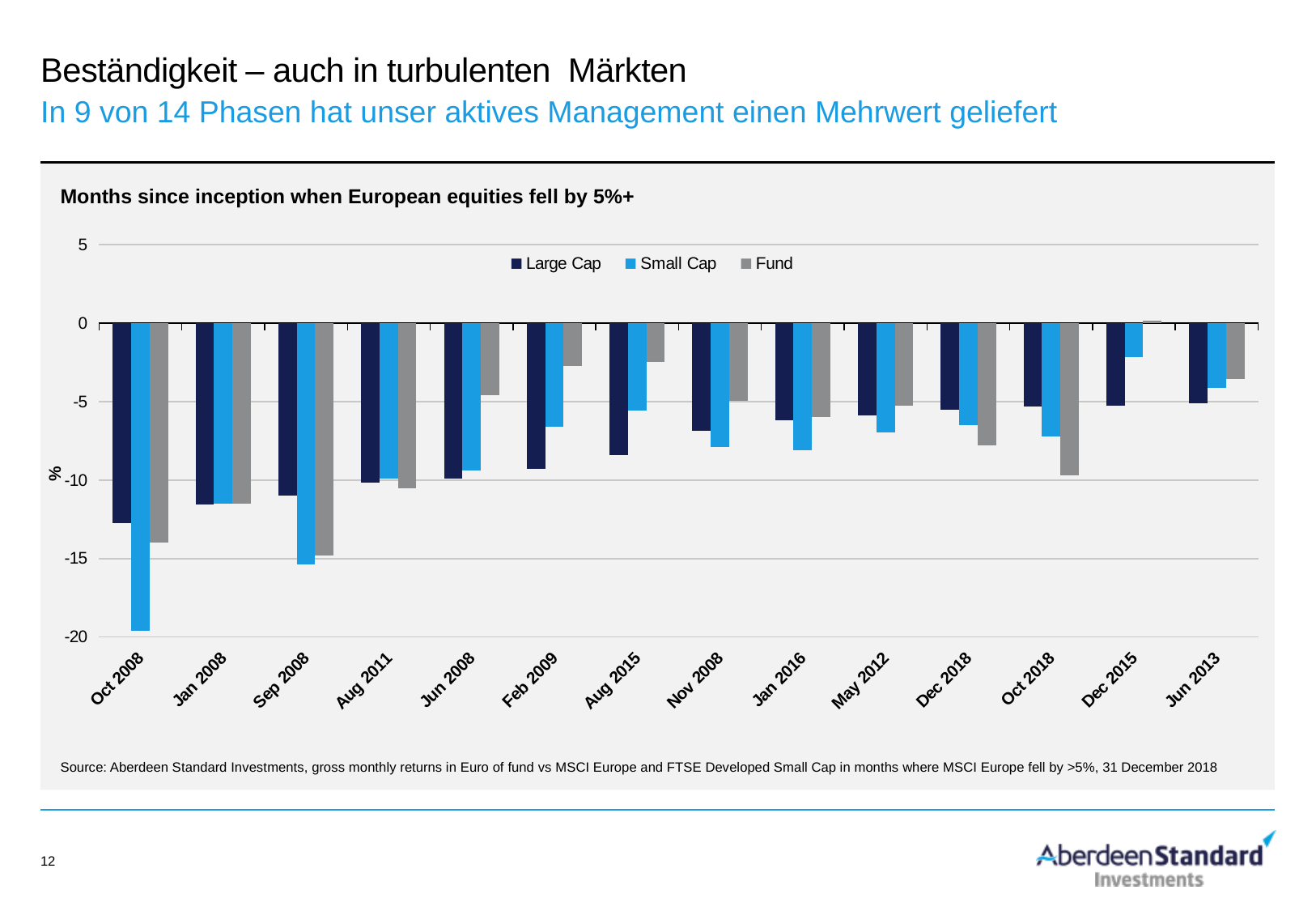
Which series are listed in the legend? Large Cap, Small Cap, Fund What kind of chart is shown on the slide? Bar chart How many series does the legend list? 3 How many months (categories) are shown on the x axis? 14 Is the Fund value for Aug 2015 greater or less than -5? greater What is the title of the chart? Months since inception when European equities fell by 5%+ Is the Fund value for Oct 2018 greater or less than -5? less In which month does the Small Cap series reach its lowest value? Oct 2008 In Oct 2018, which is lower, the Fund value or the Small Cap value? Fund Is the Small Cap value for Dec 2015 greater or less than -5? greater